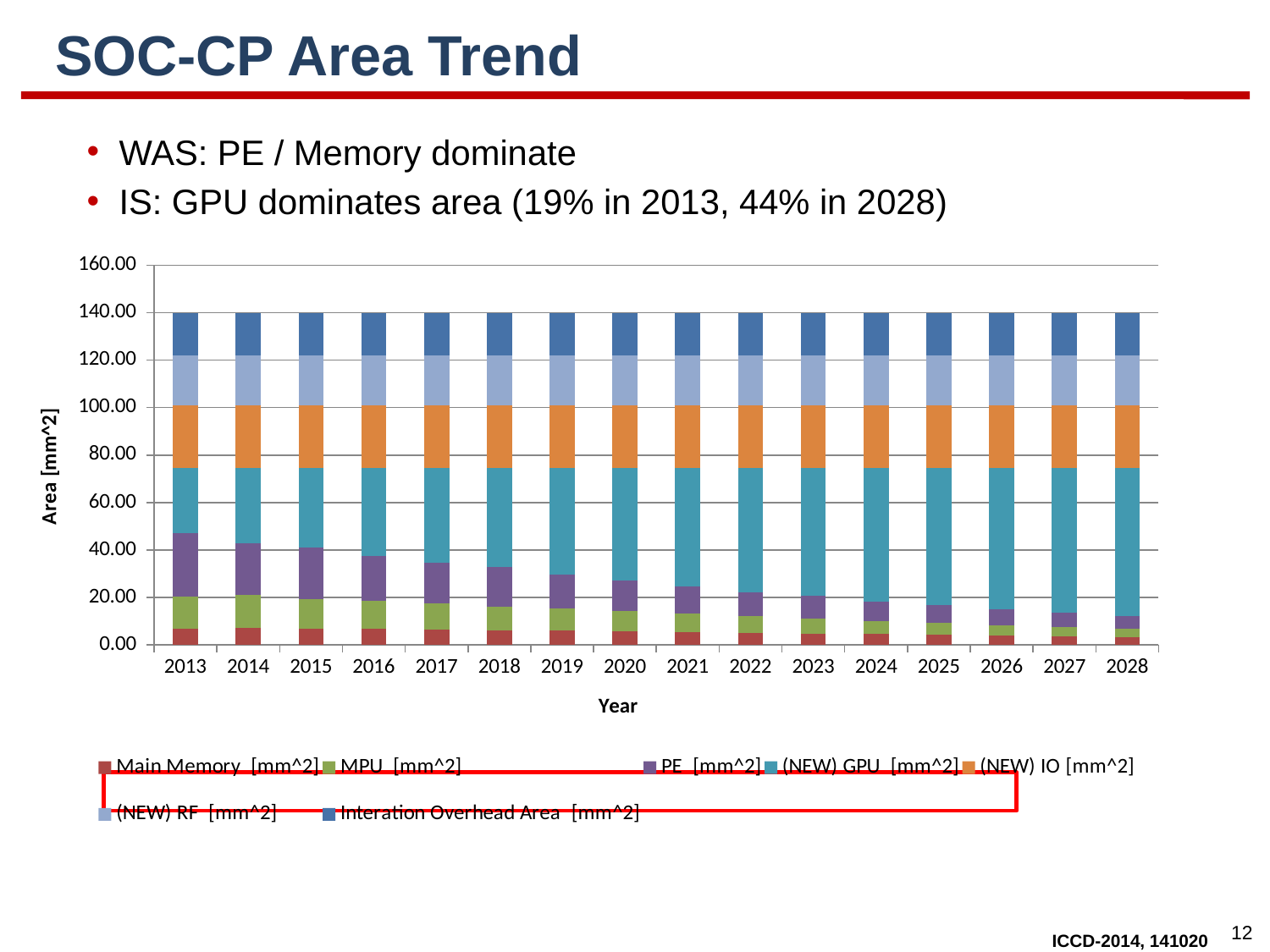
Is the total stacked value for 2013 greater or less than 120? greater What kind of chart is shown on the slide? Stacked bar chart How many years are shown along the x axis of the chart? 16 Is the total stacked value for 2028 greater or less than 160? less Is the (NEW) GPU [mm^2] segment larger in 2013 or in 2028? 2028 What is the title of the chart's x axis? Year How many series does the chart's legend list? 7 What is the title of the chart's y axis? Area [mm^2] Does the (NEW) GPU [mm^2] segment rise or fall from 2013 to 2028? Rise Which year has the largest PE [mm^2] segment? 2013 Does the PE [mm^2] segment rise or fall from 2013 to 2028? Fall Is the PE [mm^2] segment larger in 2013 or in 2028? 2013